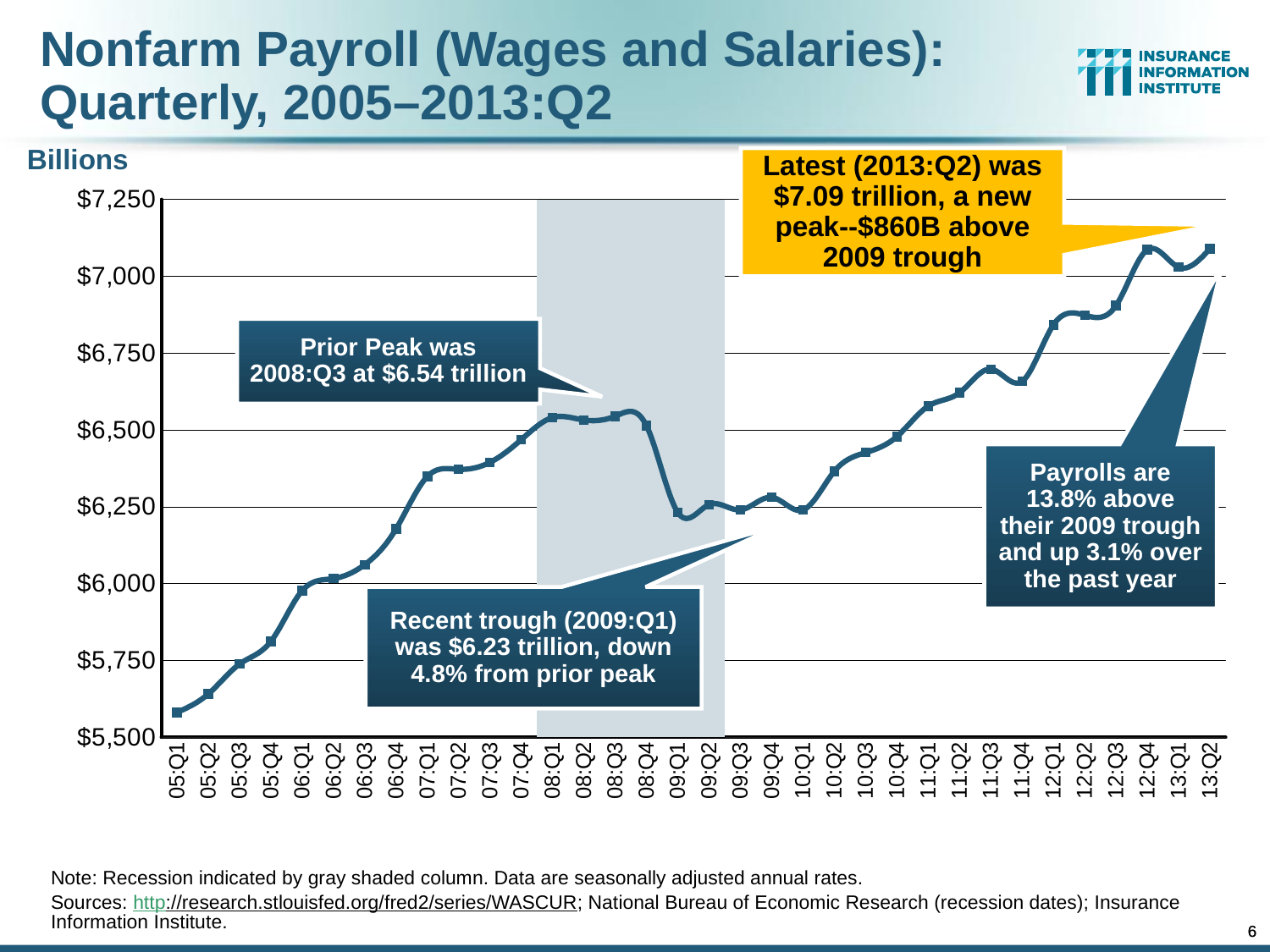
Is the value for 12:Q1 greater or less than $6,750? greater How much higher is the 2013:Q2 value than the 2009 trough? $860B What does the gray shaded column on the chart indicate? Recession What kind of chart is shown on the slide? line chart What was the nonfarm payroll value in 2013:Q2? $7.09 trillion Which is larger, the value in 2008:Q3 or the value in 2013:Q2? 2013:Q2 Which quarter has the lowest nonfarm payroll value on the chart? 05:Q1 What was the nonfarm payroll value at the recent trough in 2009:Q1? $6.23 trillion Is the value for 05:Q1 greater or less than $5,750? less What was the nonfarm payroll value at the prior peak in 2008:Q3? $6.54 trillion Is the value for 07:Q1 greater or less than $6,250? greater Which quarter has the highest nonfarm payroll value on the chart? 13:Q2